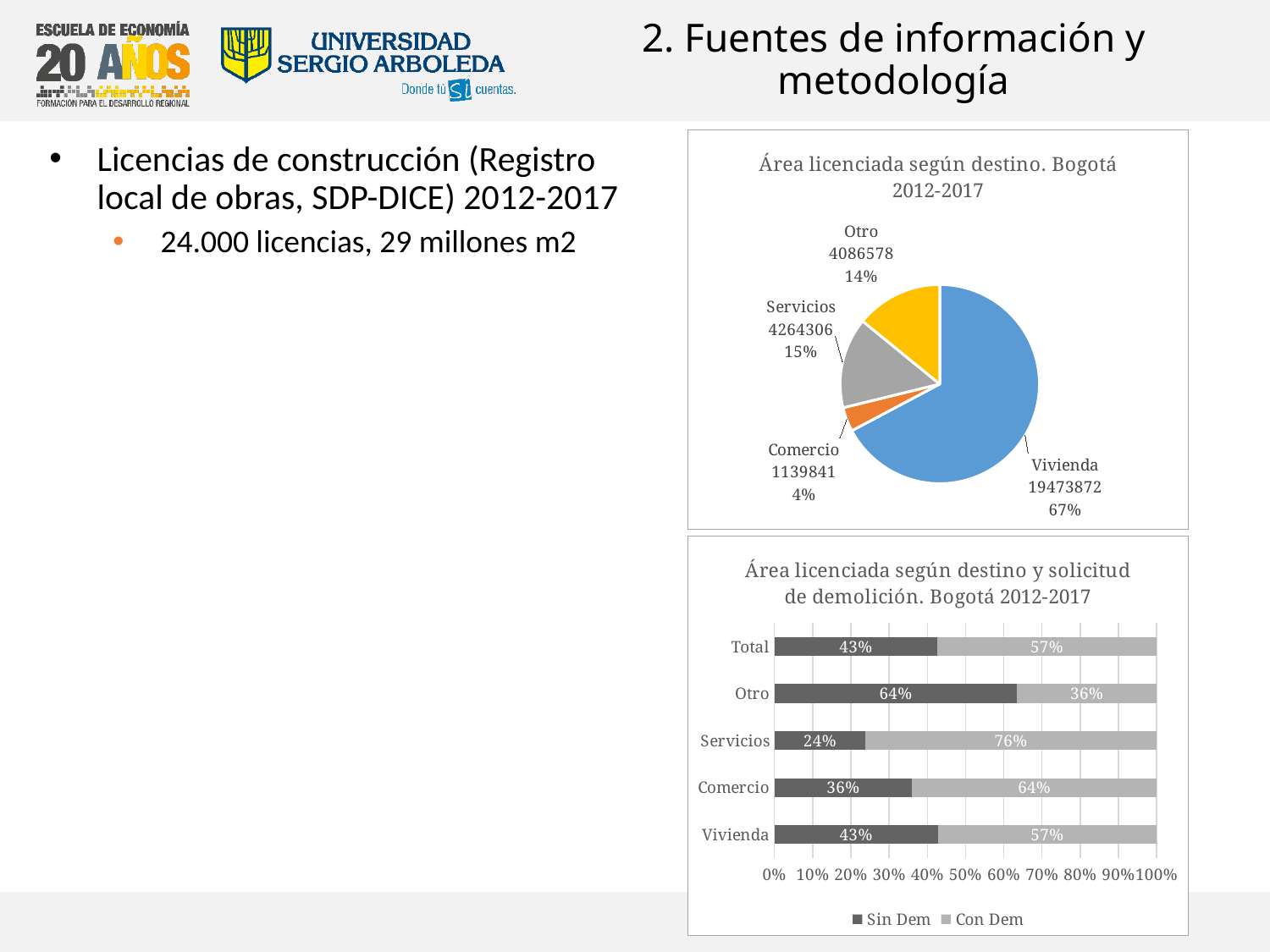
In the chart 'Área licenciada según destino y solicitud de demolición. Bogotá 2012-2017', how many series does the legend list? 2 In the pie chart 'Área licenciada según destino. Bogotá 2012-2017', which category has the largest slice? Vivienda In the pie chart 'Área licenciada según destino. Bogotá 2012-2017', what is the difference between the values for Servicios and Otro? 177728 In the pie chart 'Área licenciada según destino. Bogotá 2012-2017', which category has the smallest slice? Comercio What type of chart is the bottom chart on the right, 'Área licenciada según destino y solicitud de demolición. Bogotá 2012-2017'? Stacked bar chart In the pie chart 'Área licenciada según destino. Bogotá 2012-2017', what share of the pie does Servicios represent? 15% In the chart 'Área licenciada según destino y solicitud de demolición. Bogotá 2012-2017', which category has the highest Sin Dem share? Otro In the chart 'Área licenciada según destino y solicitud de demolición. Bogotá 2012-2017', what is the Sin Dem value for Servicios? 24% What type of chart is the top chart on the right, 'Área licenciada según destino. Bogotá 2012-2017'? Pie chart In the pie chart 'Área licenciada según destino. Bogotá 2012-2017', what is the value for Vivienda? 19473872 In the pie chart 'Área licenciada según destino. Bogotá 2012-2017', how many slices are there? 4 In the chart 'Área licenciada según destino y solicitud de demolición. Bogotá 2012-2017', is the Con Dem value for Comercio larger or smaller than the Con Dem value for Otro? Larger